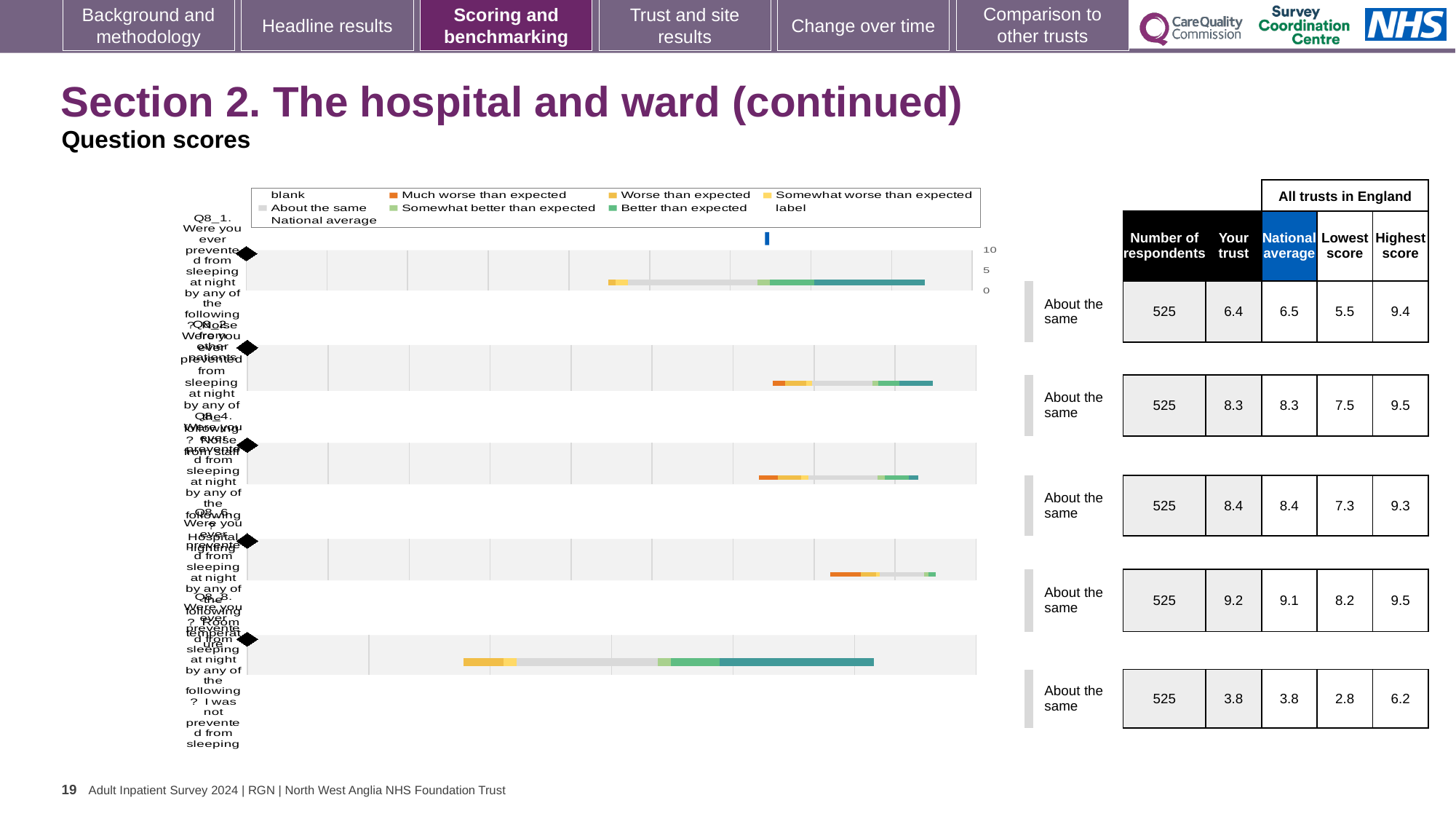
What is the national average for the first question (Q8_1) in the table beside the chart? 6.5 What is the 'Your trust' score for the last question (Q8_8) in the table beside the chart? 3.8 What kind of chart is shown on the slide? bar chart How many respondents are listed for each question in the table beside the chart? 525 Which question row has the lowest 'Your trust' score in the table beside the chart? Q8_8 What is the benchmark rating shown next to every bar in the chart? About the same What is the highest score across all trusts in England for the last question (Q8_8)? 6.2 Which question row has the highest 'Your trust' score in the table beside the chart? Q8_6 What is the 'Your trust' score for the first question (Q8_1) in the table beside the chart? 6.4 Which legend entry is shown with an orange colour in the chart? Much worse than expected What is the difference between the highest score (9.4) and the lowest score (5.5) for the first question (Q8_1)? 3.9 How many question bars are plotted in the chart? 5